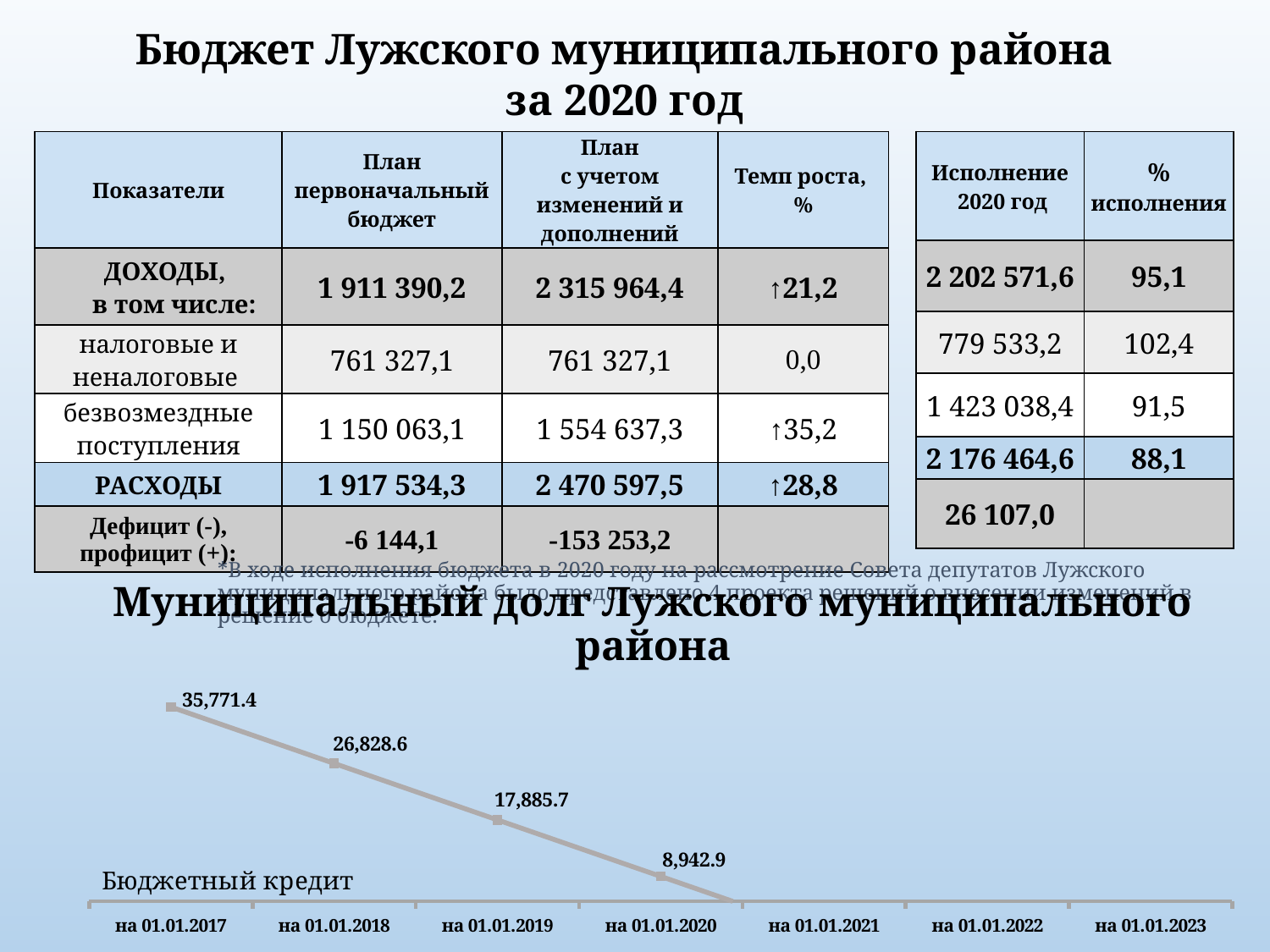
In the municipal debt chart, what is the value for на 01.01.2017? 35,771.4 What type of chart is shown under the title "Муниципальный долг Лужского муниципального района"? line chart In the municipal debt chart, which is larger: the value for на 01.01.2019 or на 01.01.2020? на 01.01.2019 In the municipal debt chart, which labelled date has the highest value? на 01.01.2017 How many date labels are shown on the x axis of the municipal debt chart? 7 In the municipal debt chart, what is the difference between the values for на 01.01.2017 and на 01.01.2018? 8,942.8 In the municipal debt chart, what is the value for на 01.01.2019? 17,885.7 In the municipal debt chart, what is the value for на 01.01.2018? 26,828.6 In the municipal debt chart, do the values rise or fall from на 01.01.2017 to на 01.01.2020? fall In the municipal debt chart, which of the labelled points has the lowest value? на 01.01.2020 In the municipal debt chart, what is the value for на 01.01.2020? 8,942.9